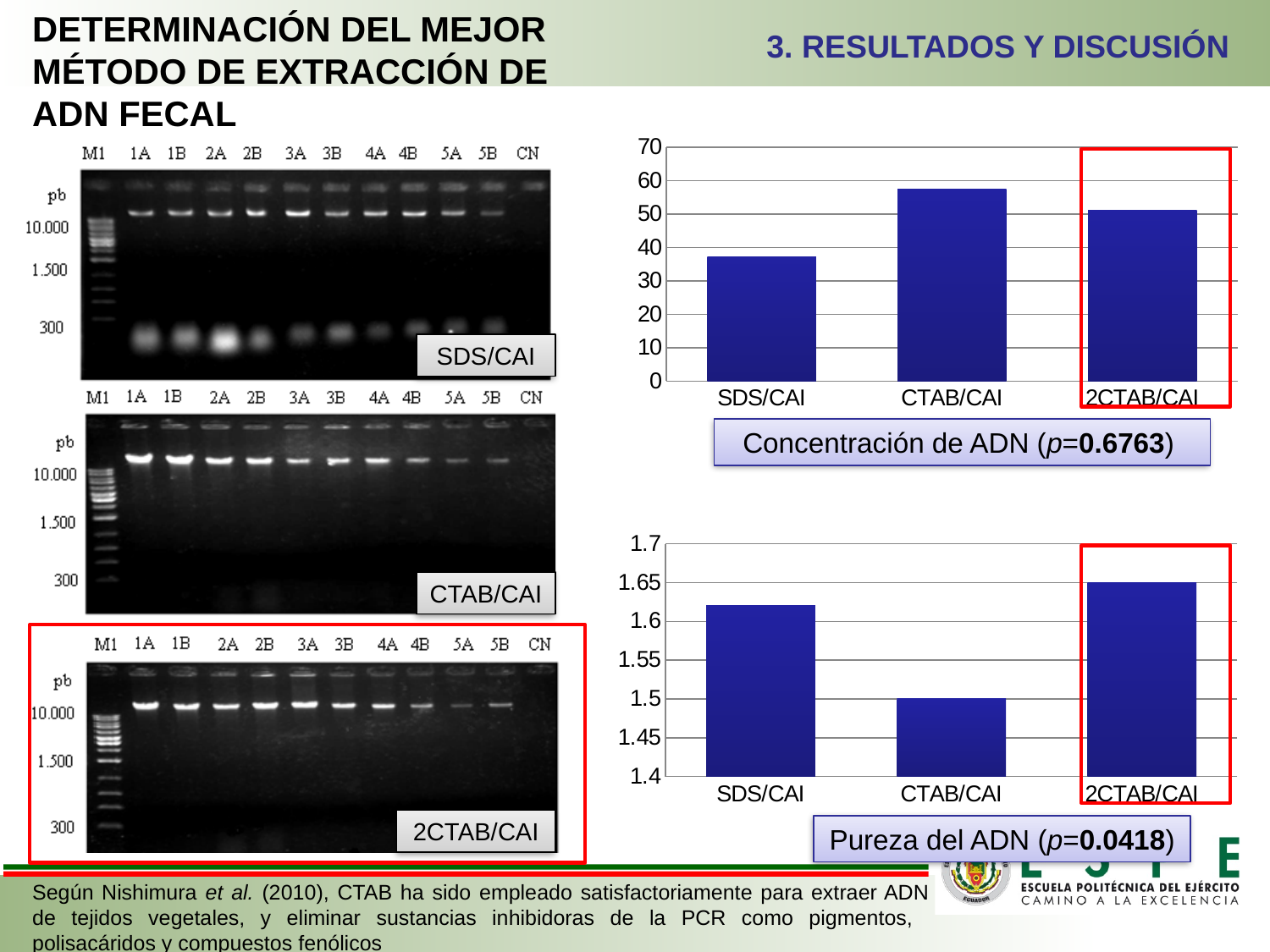
In the 'Concentración de ADN' chart, which category has the highest value? CTAB/CAI In the 'Concentración de ADN' chart, is the value for SDS/CAI greater or less than 40? less In the 'Concentración de ADN' chart, how many categories are plotted? 3 What p-value is shown in the title of the 'Pureza del ADN' chart? 0.0418 In the 'Concentración de ADN' chart, which category has the lowest value? SDS/CAI In the 'Pureza del ADN' chart, what is the value for CTAB/CAI? 1.5 In the 'Concentración de ADN' chart, which is larger, the value for CTAB/CAI or the value for 2CTAB/CAI? CTAB/CAI In the 'Concentración de ADN' chart, what kind of chart is shown? bar chart In the 'Pureza del ADN' chart, which category has the highest value? 2CTAB/CAI In the 'Pureza del ADN' chart, which category has the lowest value? CTAB/CAI In the 'Pureza del ADN' chart, is the value for SDS/CAI greater or less than 1.6? greater